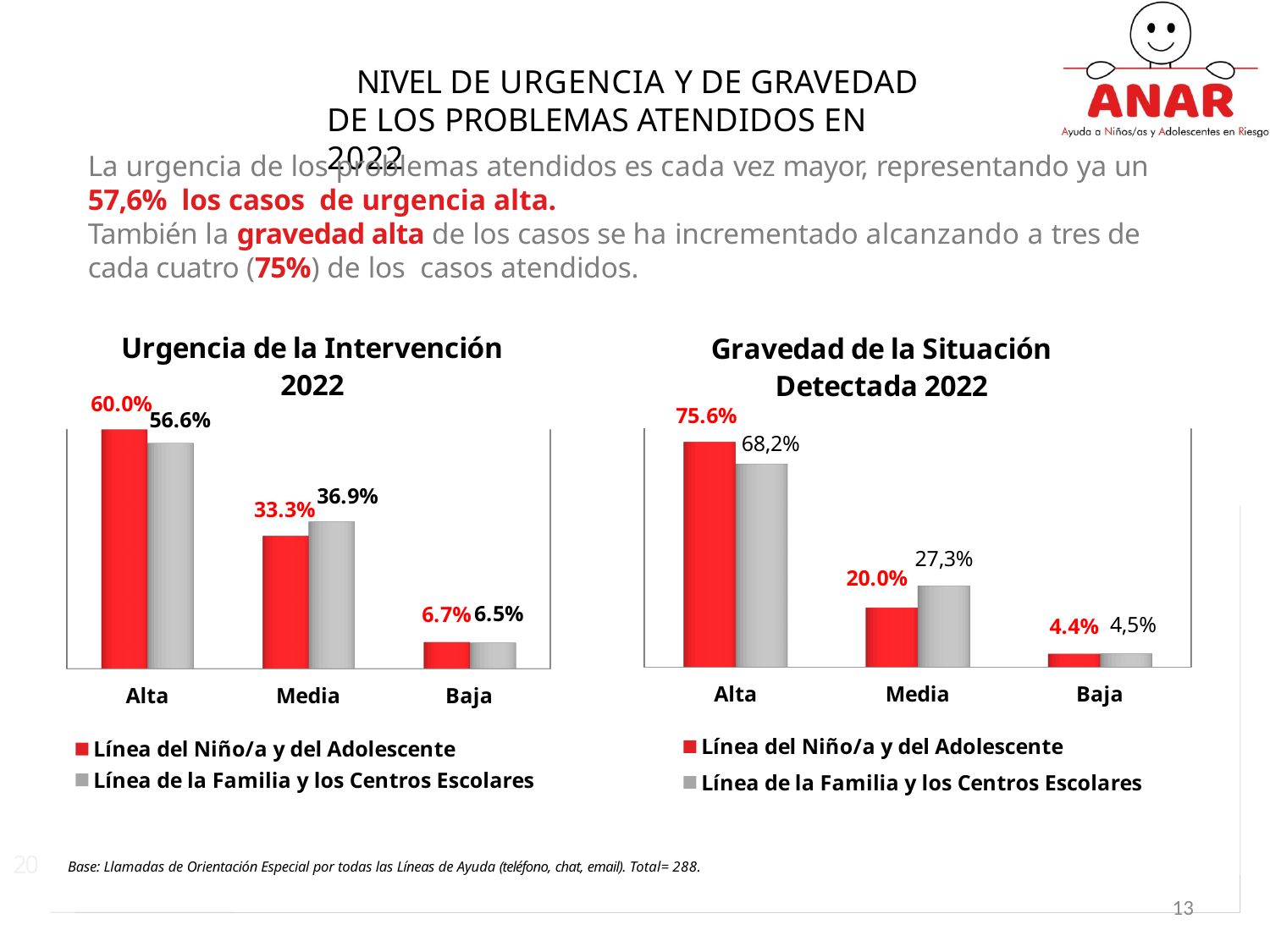
In the 'Gravedad de la Situación Detectada 2022' chart, what is the value for Alta in the Línea del Niño/a y del Adolescente series? 75.6% In the 'Gravedad de la Situación Detectada 2022' chart, for Media, which series has the larger value? Línea de la Familia y los Centros Escolares What type of chart is the 'Urgencia de la Intervención 2022' chart? Bar chart How many series does the legend of the 'Gravedad de la Situación Detectada 2022' chart list? 2 How many categories are shown on the x axis of the 'Urgencia de la Intervención 2022' chart? 3 In the 'Urgencia de la Intervención 2022' chart, what is the value for Media in the Línea de la Familia y los Centros Escolares series? 36.9% In the 'Urgencia de la Intervención 2022' chart, what is the value for Alta in the Línea del Niño/a y del Adolescente series? 60.0% In the 'Gravedad de la Situación Detectada 2022' chart, what is the value for Media in the Línea de la Familia y los Centros Escolares series? 27,3% In the 'Gravedad de la Situación Detectada 2022' chart, which category has the highest value for the Línea de la Familia y los Centros Escolares series? Alta In the 'Gravedad de la Situación Detectada 2022' chart, what is the value for Baja in the Línea de la Familia y los Centros Escolares series? 4,5% In the 'Urgencia de la Intervención 2022' chart, which category has the lowest value for the Línea del Niño/a y del Adolescente series? Baja In the 'Urgencia de la Intervención 2022' chart, what is the difference between the two series' values for Alta? 3.4%